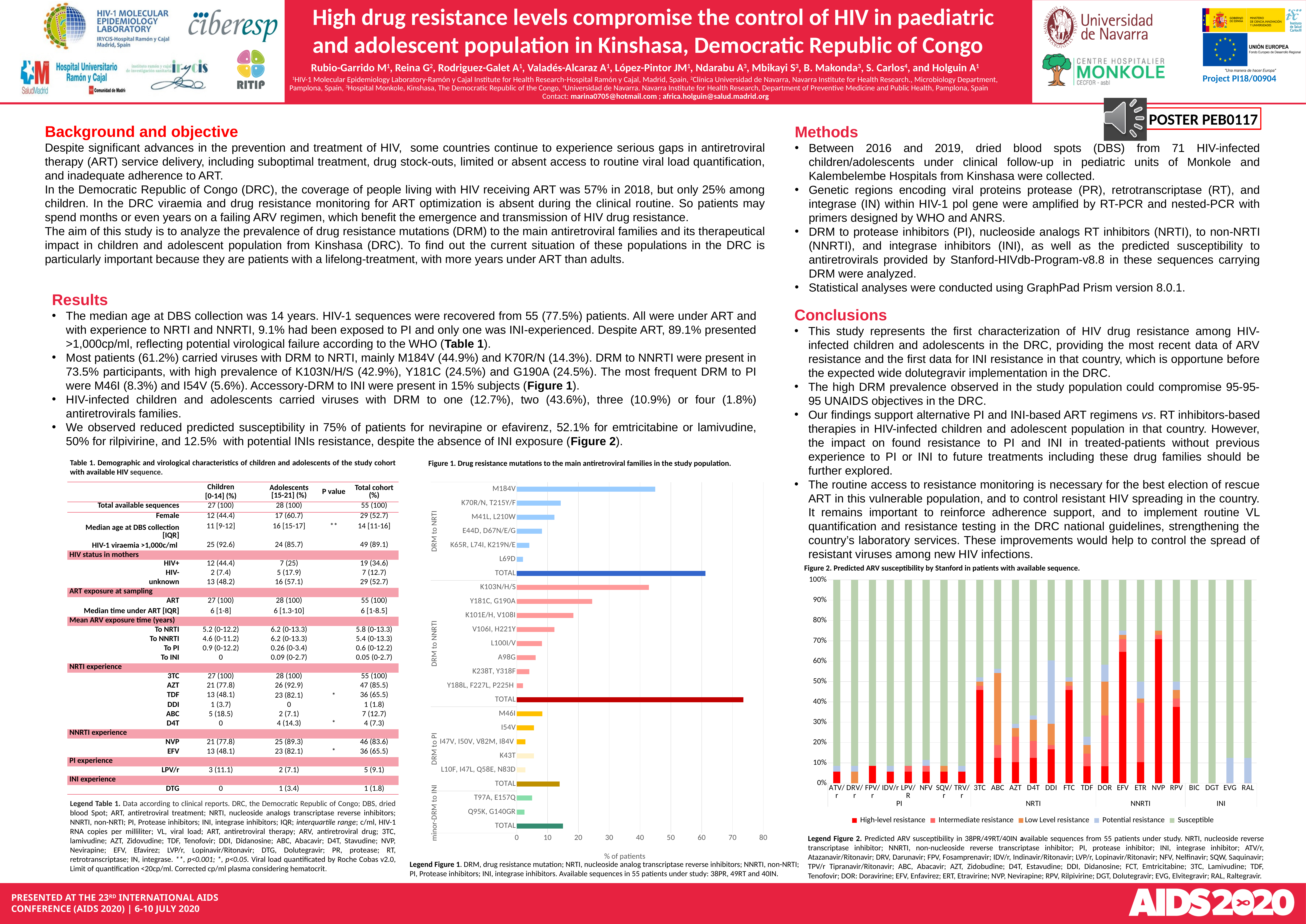
In Figure 1, what is the label of the x axis? % of patients In Figure 2, how many series does the legend list? 5 In Figure 1, which mutation in the DRM to NRTI group has the shortest bar? L69D What kind of chart is Figure 1, 'Drug resistance mutations to the main antiretroviral families in the study population'? bar chart In Figure 1, is the TOTAL for DRM to NNRTI greater or less than 70? greater What kind of chart is Figure 2, 'Predicted ARV susceptibility by Stanford in patients with available sequence'? stacked bar chart In Figure 1, how many mutation categories (excluding TOTAL) are listed in the DRM to NNRTI group? 8 In Figure 1, which bar is the longest overall? TOTAL (DRM to NNRTI) In Figure 2, is the high-level resistance share for NVP greater or less than 60%? greater In Figure 1, which is larger: the value for M184V or the value for K70R/N, T215Y/F? M184V In Figure 1, is the TOTAL for DRM to PI greater or less than 20? less